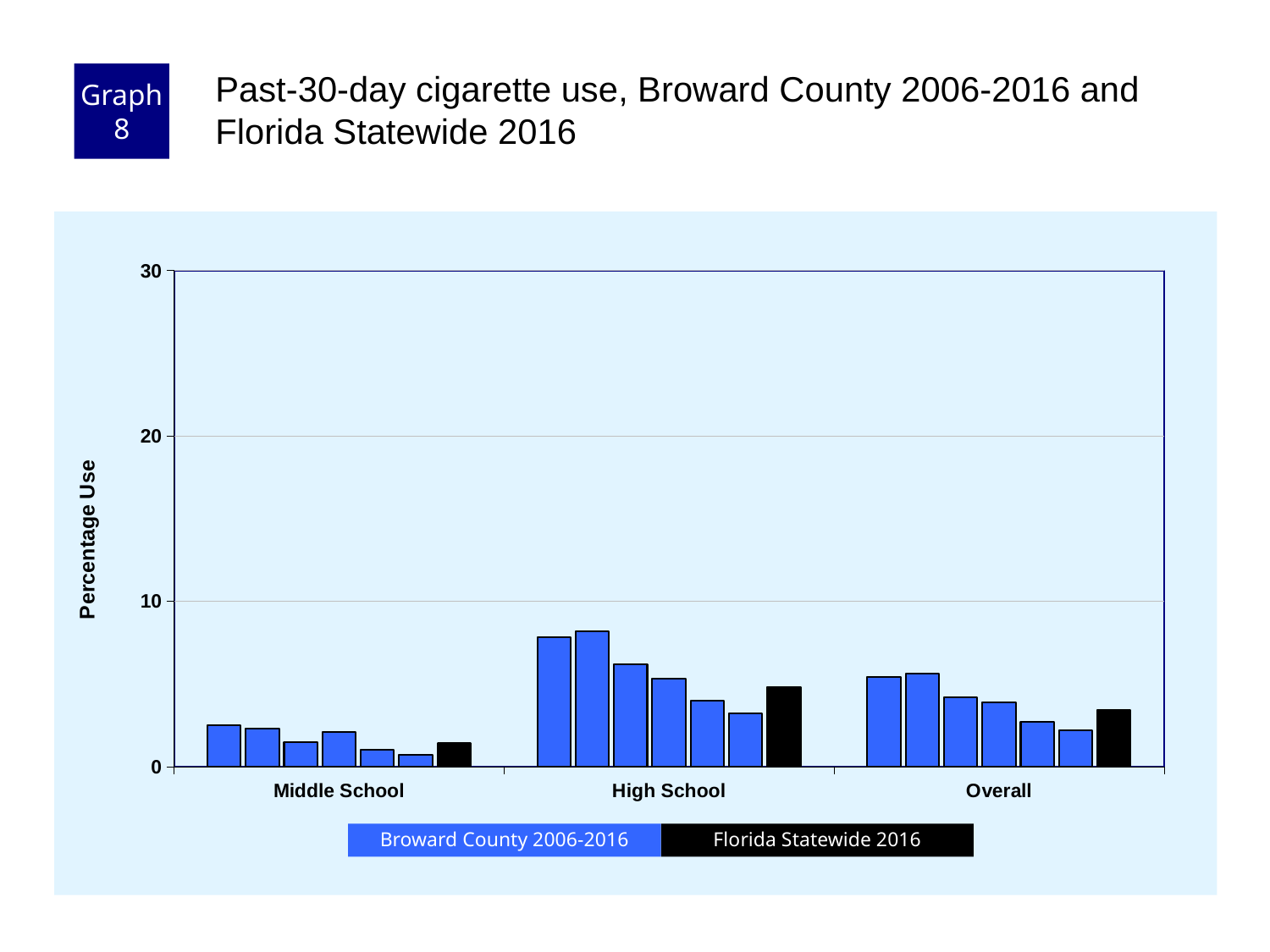
Which category has the lowest bars overall? Middle School Which is larger: the Florida Statewide 2016 bar for High School or the Florida Statewide 2016 bar for Middle School? High School Within the High School category, do the Broward County 2006-2016 bars generally rise or fall from left to right? fall Is the Florida Statewide 2016 value for High School greater or less than 10? less What is the label on the y axis? Percentage Use How many series does the legend list? 2 How many categories are shown on the x axis? 3 What colour represents Florida Statewide 2016 in the legend? black Is the tallest Broward County bar for High School greater or less than 10? less Is the Florida Statewide 2016 value for Middle School greater or less than 10? less Which category has the highest bars overall? High School What kind of chart is shown on the slide? bar chart